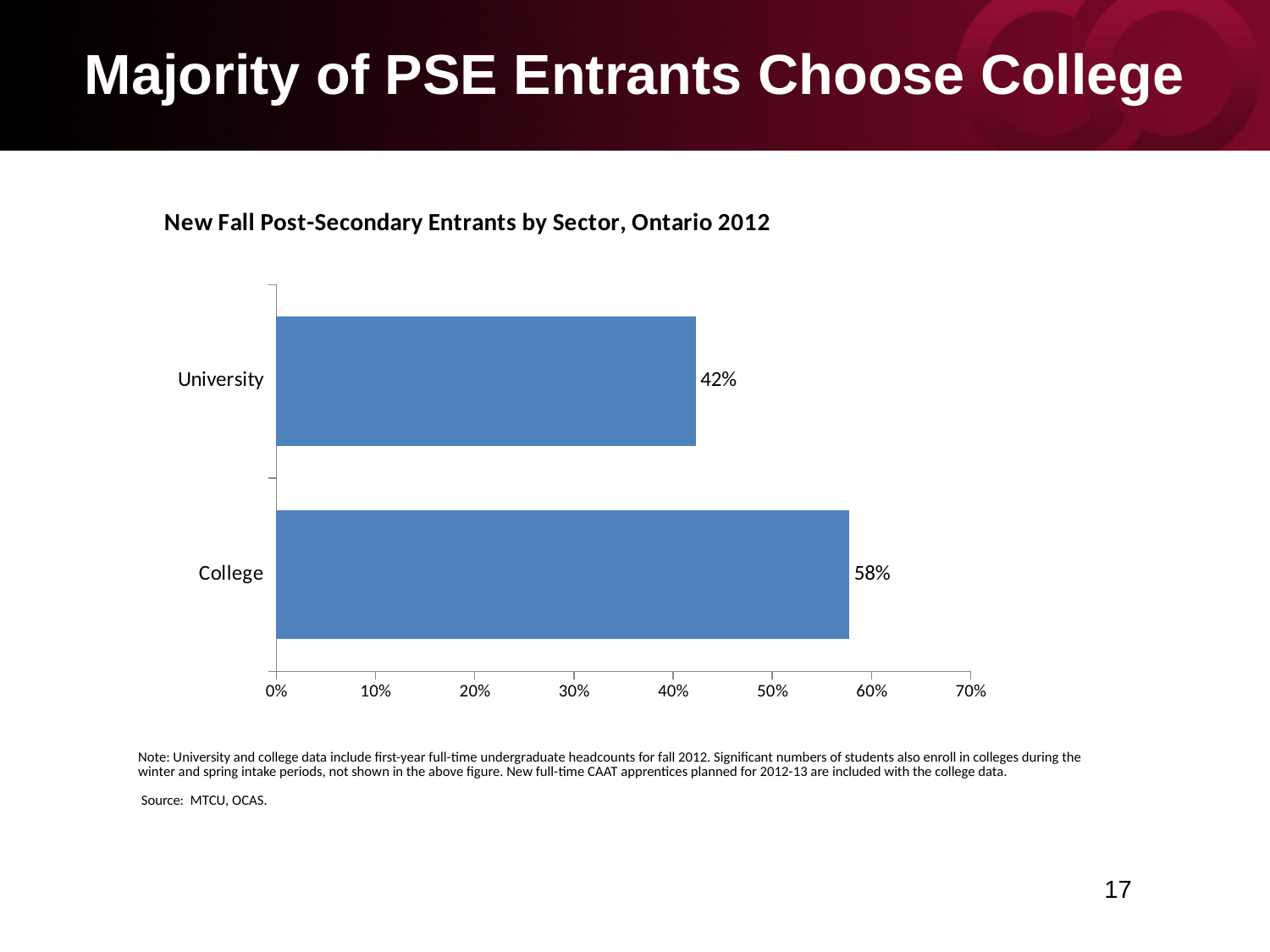
Is the value for College greater or less than 50%? greater What is the value for University? 42% What is the maximum value shown on the x axis? 70% Which sector has the highest share of new fall post-secondary entrants? College Which is larger, the value for College or the value for University? College What is the title of the chart? New Fall Post-Secondary Entrants by Sector, Ontario 2012 Is the value for University greater or less than 50%? less What kind of chart is shown on the slide? bar chart What is the difference between the College and University values? 16% How many categories are shown in the chart? 2 Which sector has the lowest share of new fall post-secondary entrants? University What is the value for College? 58%